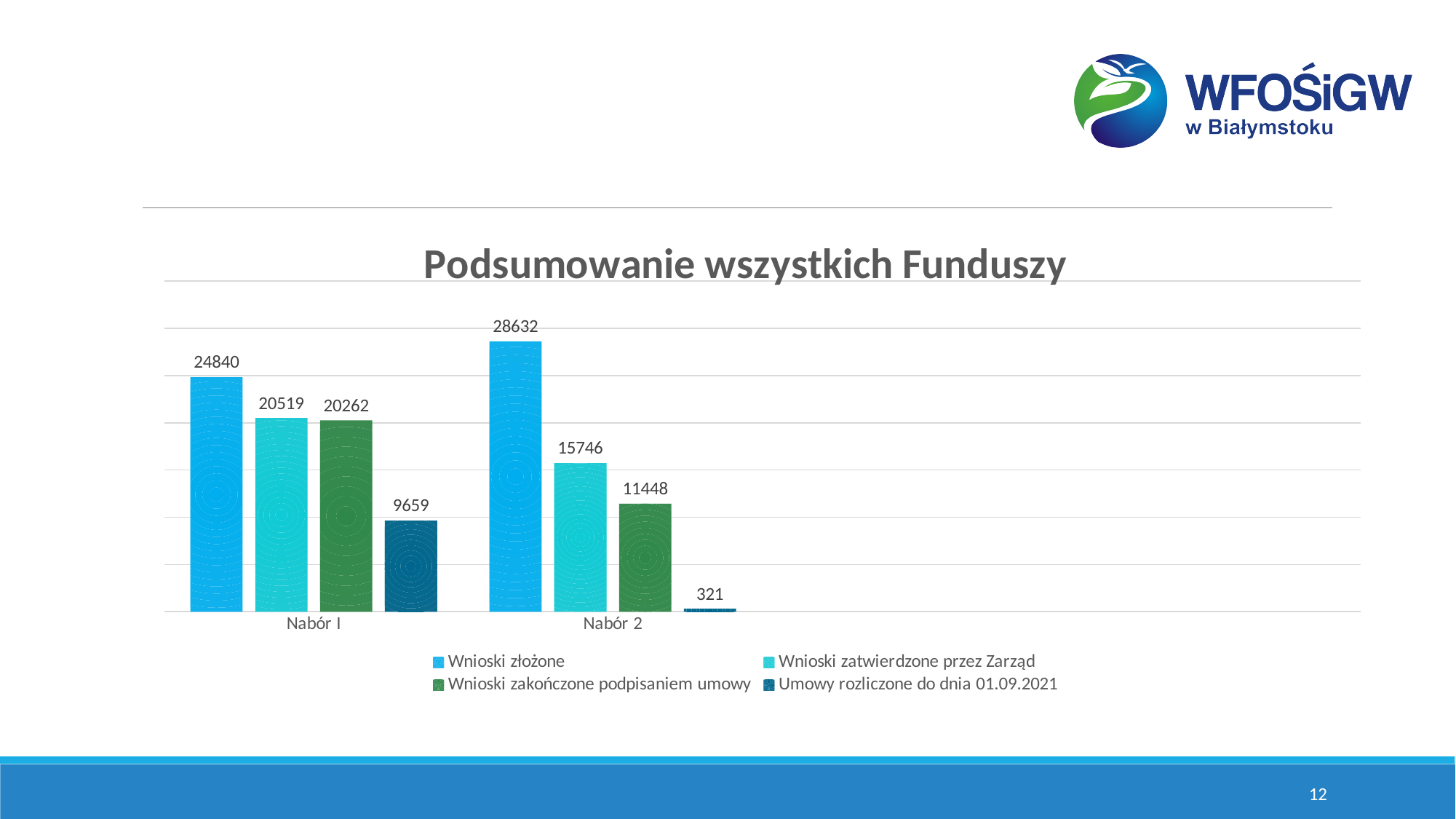
How many series does the legend list? 4 What is the value of Wnioski złożone for Nabór I? 24840 Which series has the highest value for Nabór 2? Wnioski złożone What is the value of Wnioski zatwierdzone przez Zarząd for Nabór 2? 15746 Which series has the lowest value for Nabór I? Umowy rozliczone do dnia 01.09.2021 What is the value of Wnioski zakończone podpisaniem umowy for Nabór I? 20262 What is the difference between Wnioski złożone for Nabór 2 and Wnioski złożone for Nabór I? 3792 What is the title of the chart? Podsumowanie wszystkich Funduszy Which is larger: Wnioski zakończone podpisaniem umowy for Nabór I or for Nabór 2? Nabór I What kind of chart is shown on the slide? Bar chart What is the value of Umowy rozliczone do dnia 01.09.2021 for Nabór 2? 321 How many categories are shown on the x axis? 2